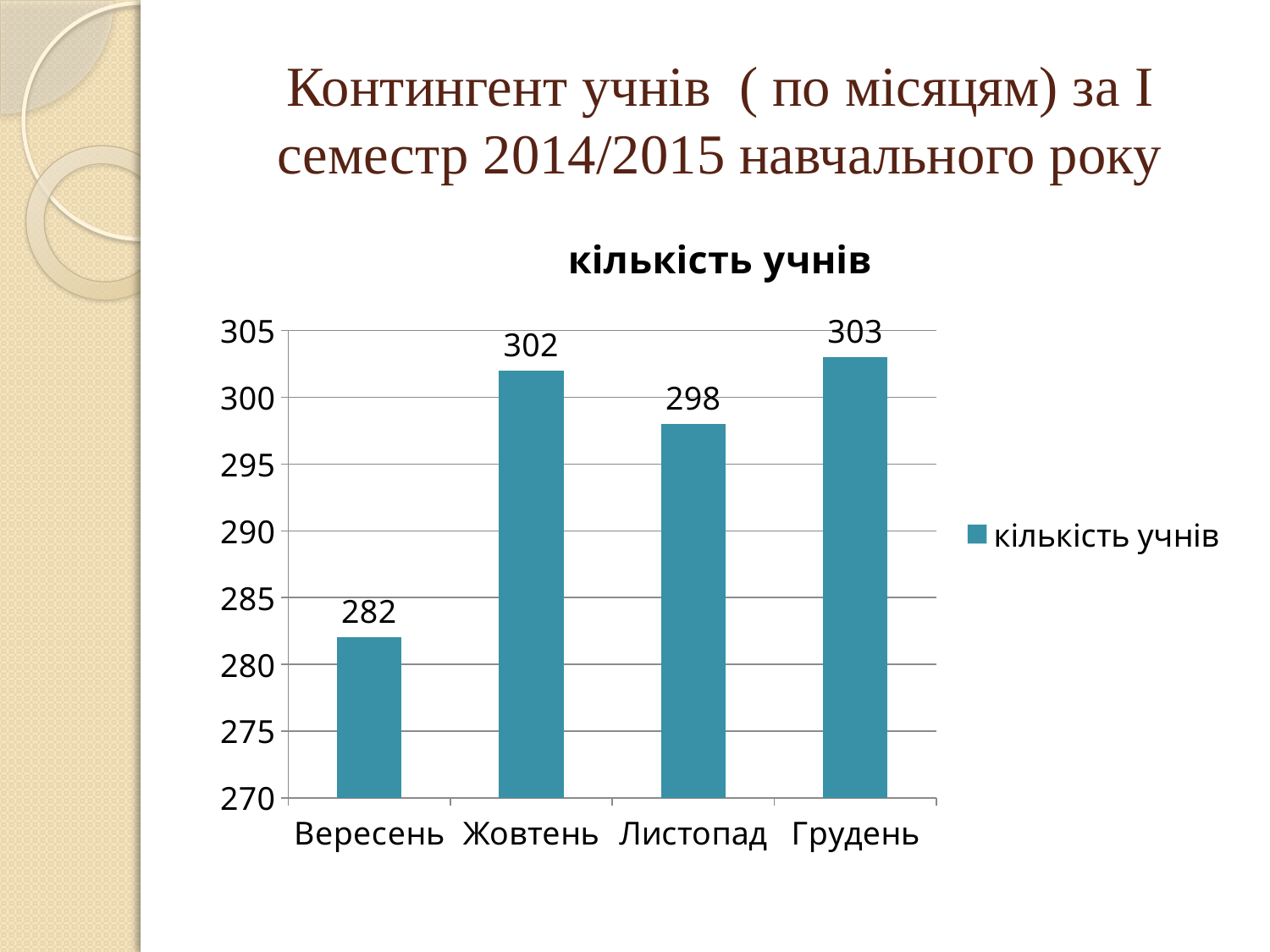
What is the value for Листопад? 298 What is the value for Вересень? 282 What is the title of the chart? кількість учнів What is the difference between the values for Грудень and Листопад? 5 What is the value for Грудень? 303 What is the difference between the values for Жовтень and Вересень? 20 Which month has the lowest value? Вересень How many months are shown on the x axis? 4 Which is larger, the value for Жовтень or the value for Листопад? Жовтень Which month has the highest value? Грудень What is the value for Жовтень? 302 What kind of chart is shown on the slide? bar chart